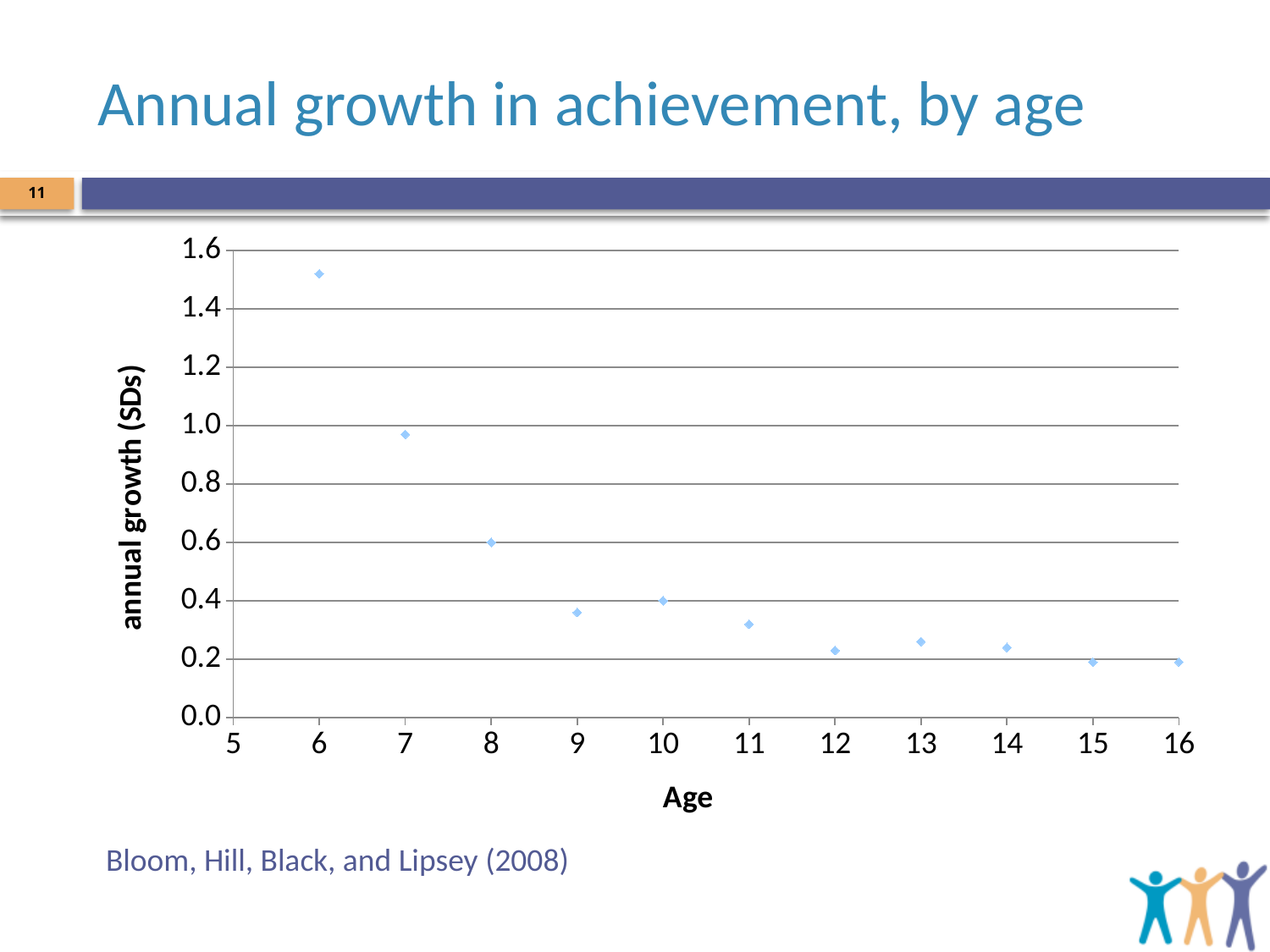
At which age is annual growth in achievement highest? 6 Is the value for age 12 greater or less than 0.2? greater What is the label on the x axis of the chart? Age Is the value for age 9 greater or less than 0.4? less What is the label on the y axis of the chart? annual growth (SDs) How many data points are plotted on the chart? 11 Is the value for age 7 greater or less than 1.0? less Do the values generally rise or fall as age increases along the x axis? fall What kind of chart is shown on the slide? scatter plot Which has the larger value, age 8 or age 9? age 8 Which has the larger value, age 6 or age 7? age 6